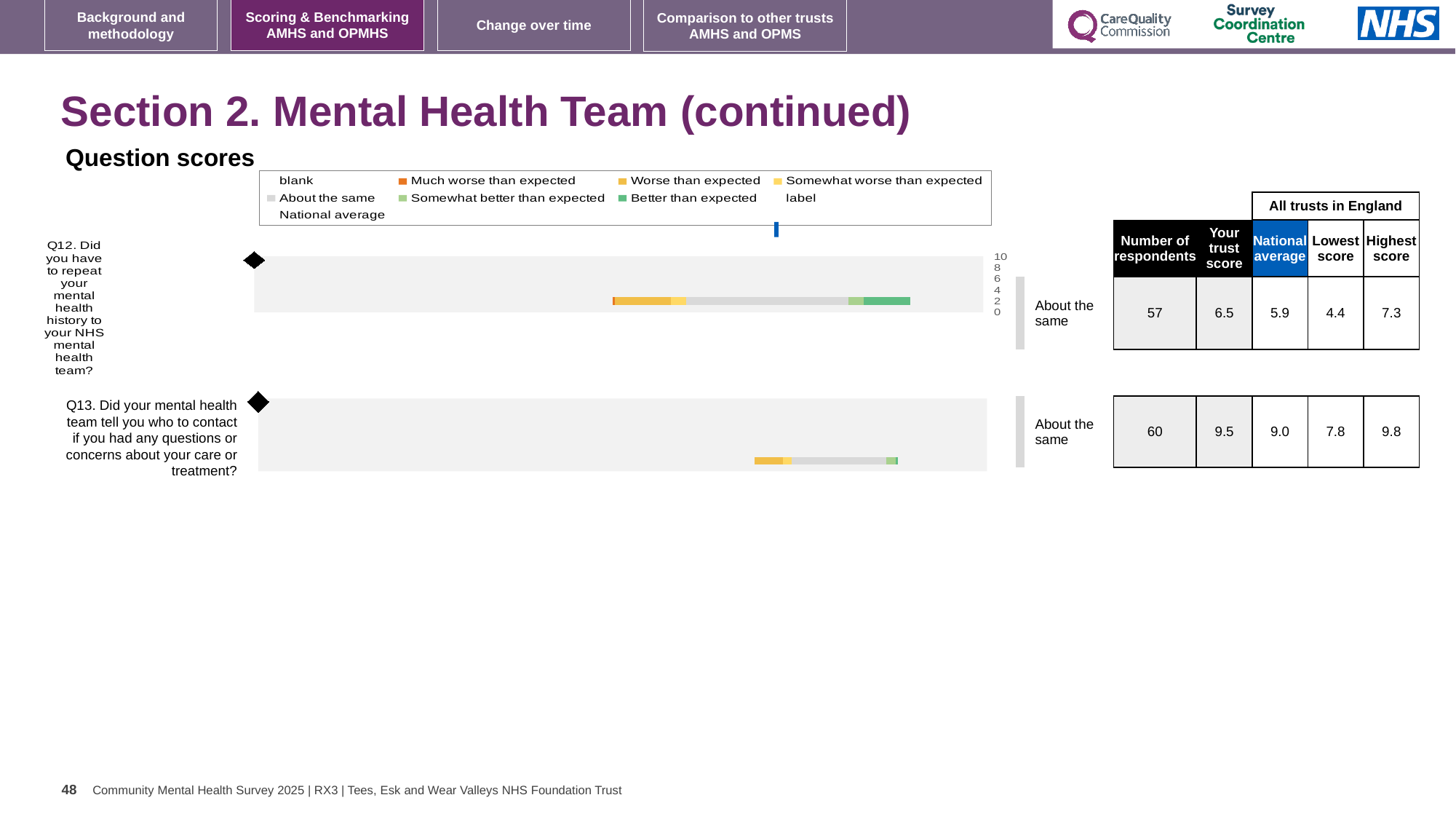
What is the difference between the trust score and the national average for Q12? 0.6 What is the national average score for Q12? 5.9 What is the trust score for Q12 (repeating mental health history)? 6.5 What kind of chart is used to show the question scores for Q12 and Q13? bar chart What is the difference between the highest and lowest scores across all trusts for Q13? 2.0 What is the lowest score among all trusts in England for Q12? 4.4 How many respondents answered Q13? 60 What benchmark rating is shown next to the Q12 chart? About the same Which question has the higher trust score, Q12 or Q13? Q13 What is the highest score among all trusts in England for Q13? 9.8 How many questions are plotted in the question scores charts on this slide? 2 What is the trust score for Q13 (told who to contact with questions or concerns)? 9.5